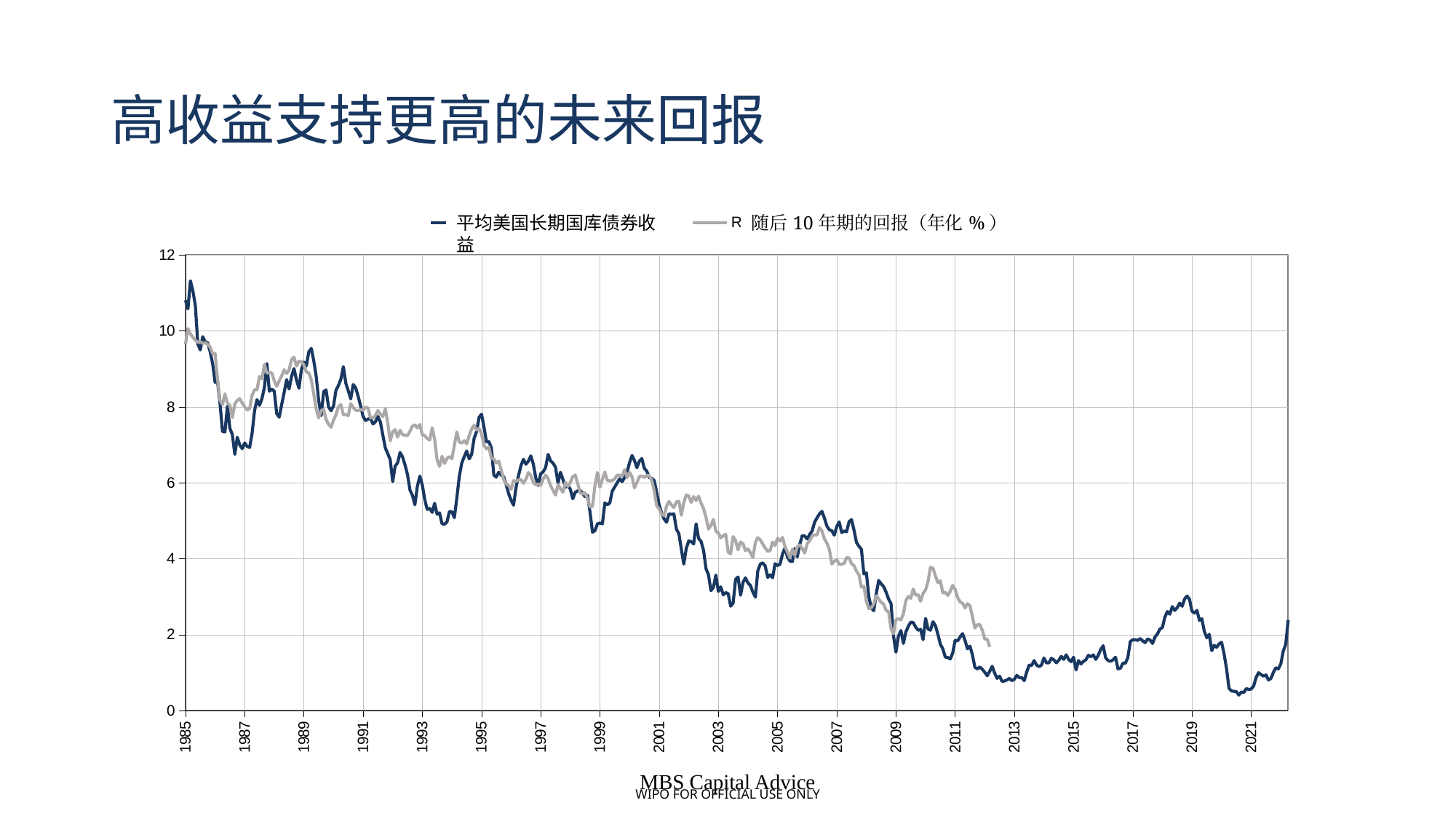
Is the value of 平均美国长期国库债券收益 at 1985 greater or less than 10? greater Which series is drawn in gray? R 随后 10 年期的回报（年化 %） What is the highest value shown on the y axis? 12 Overall, does the 平均美国长期国库债券收益 line rise or fall from 1985 to 2021? fall What kind of chart is shown on the slide? line chart What is the title of the slide? 高收益支持更高的未来回报 Is the value of 平均美国长期国库债券收益 at 2021 greater or less than 2? less At 2003, which series has the higher value: 平均美国长期国库债券收益 or R 随后 10 年期的回报（年化 %）? R 随后 10 年期的回报（年化 %） How many series does the legend list? 2 Is the value of R 随后 10 年期的回报（年化 %） at 2009 greater or less than 4? less